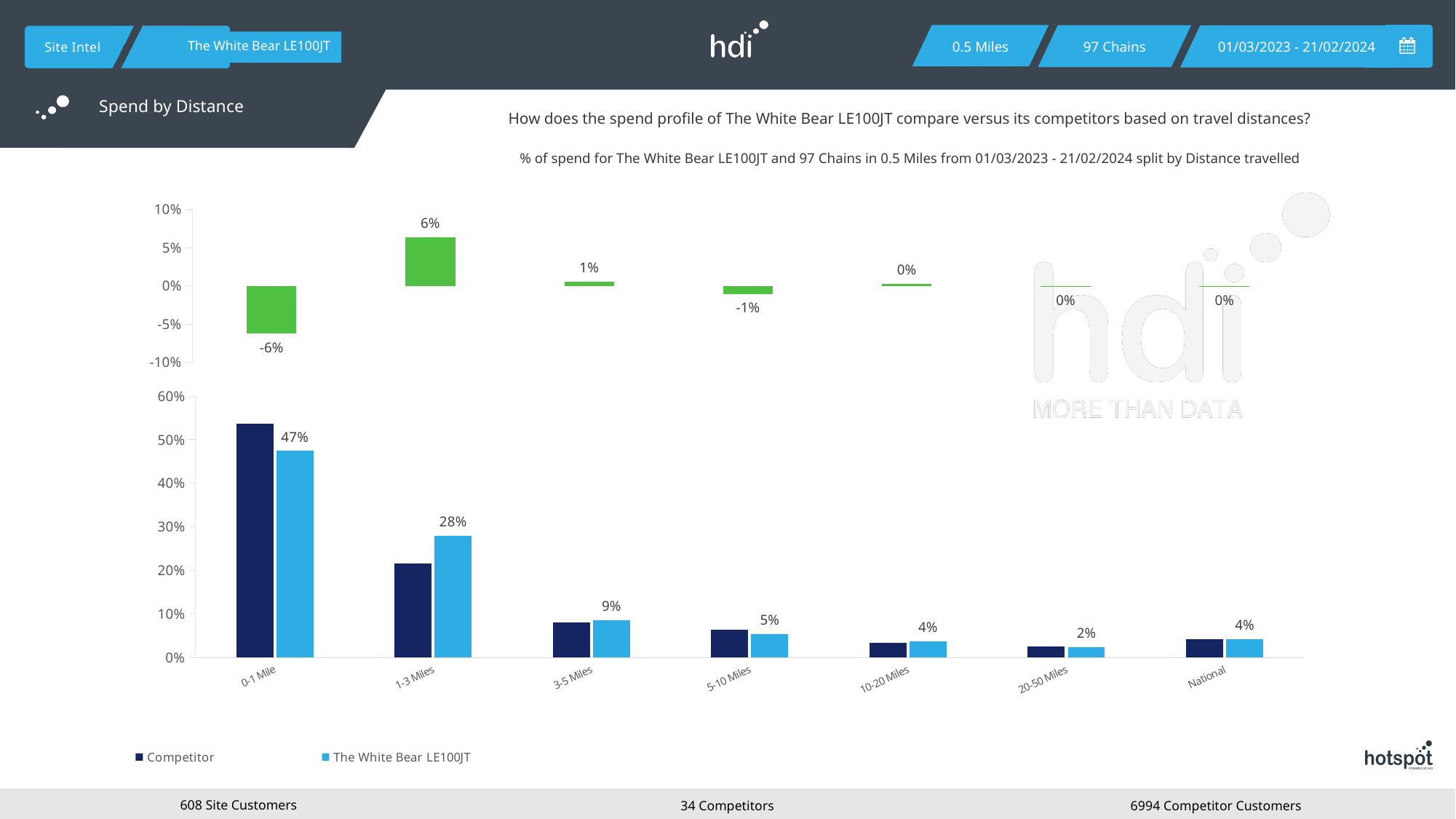
On the bottom chart, what is the value for The White Bear LE100JT in the 20-50 Miles category? 2% How many series does the legend of the bottom chart list? 2 On the bottom chart, which distance category has the lowest value for The White Bear LE100JT? 20-50 Miles On the bottom chart, is the Competitor value for 0-1 Mile greater or less than 50%? greater On the top chart, what is the value shown for the 1-3 Miles category? 6% On the bottom chart, what is the difference between The White Bear LE100JT values for 0-1 Mile and 1-3 Miles? 19% On the bottom chart, what is the value for The White Bear LE100JT in the 1-3 Miles category? 28% On the bottom chart, what is the value for The White Bear LE100JT in the 0-1 Mile category? 47% On the bottom chart, in the 0-1 Mile category, which is larger: the Competitor bar or The White Bear LE100JT bar? Competitor How many distance categories are shown on the x axis of the bottom chart? 7 On the top chart, what is the value shown for the 0-1 Mile category? -6% On the bottom chart, which distance category has the highest value for The White Bear LE100JT? 0-1 Mile